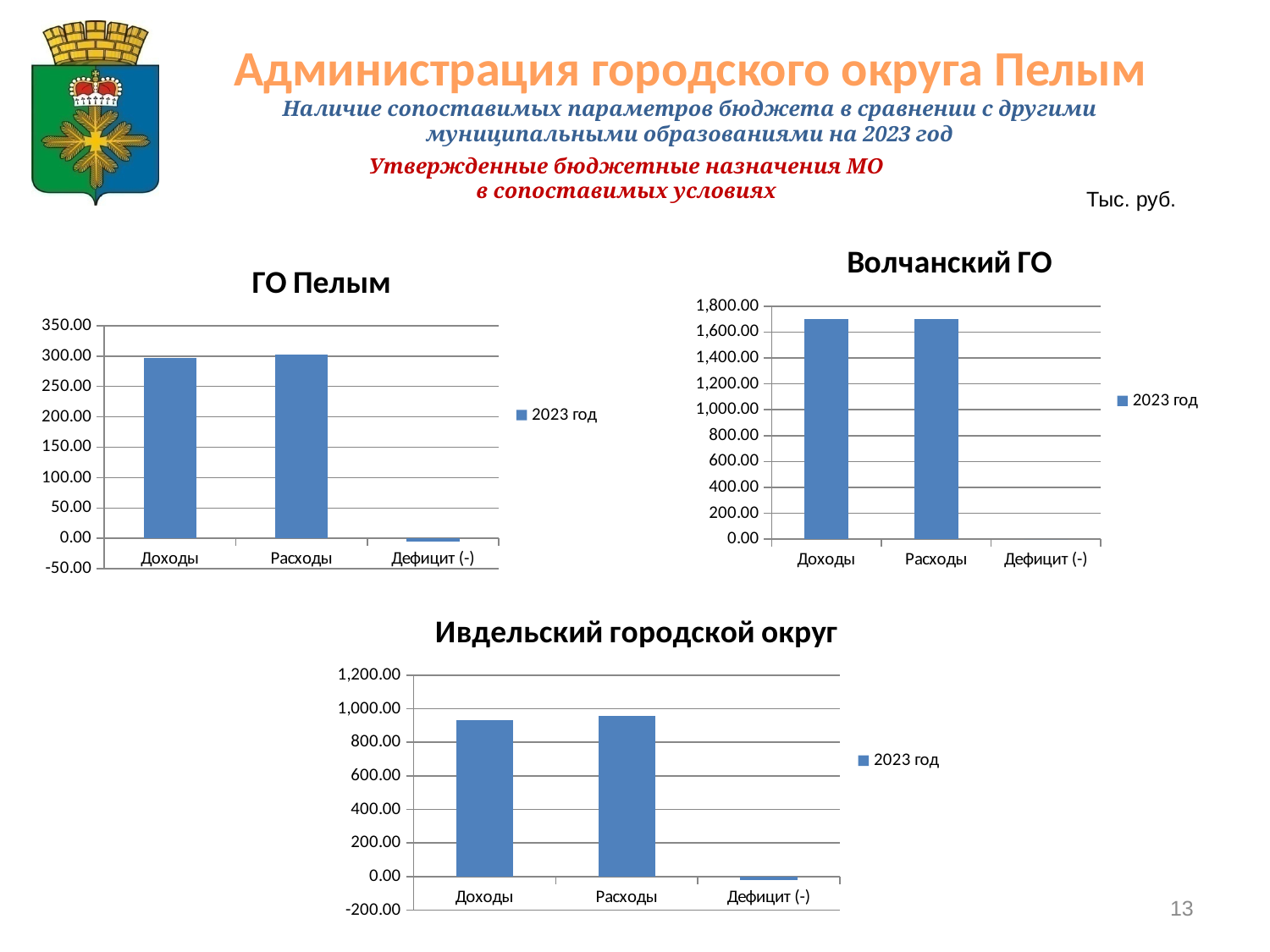
In the 'ГО Пелым' chart, is the value for Расходы greater or less than 350.00? less In the 'Волчанский ГО' chart, is the value for Доходы greater or less than 1,600.00? greater In the 'ГО Пелым' chart, is the value for Доходы greater or less than 250.00? greater How many categories are shown on the x axis of the 'Волчанский ГО' chart? 3 In the 'Ивдельский городской округ' chart, which category has the lowest value? Дефицит (-) How many series does the legend of the 'Ивдельский городской округ' chart list? 1 What kind of chart is the 'ГО Пелым' chart? bar chart In the 'ГО Пелым' chart, which category has the lowest value? Дефицит (-) What series name appears in the legend of the 'Волчанский ГО' chart? 2023 год